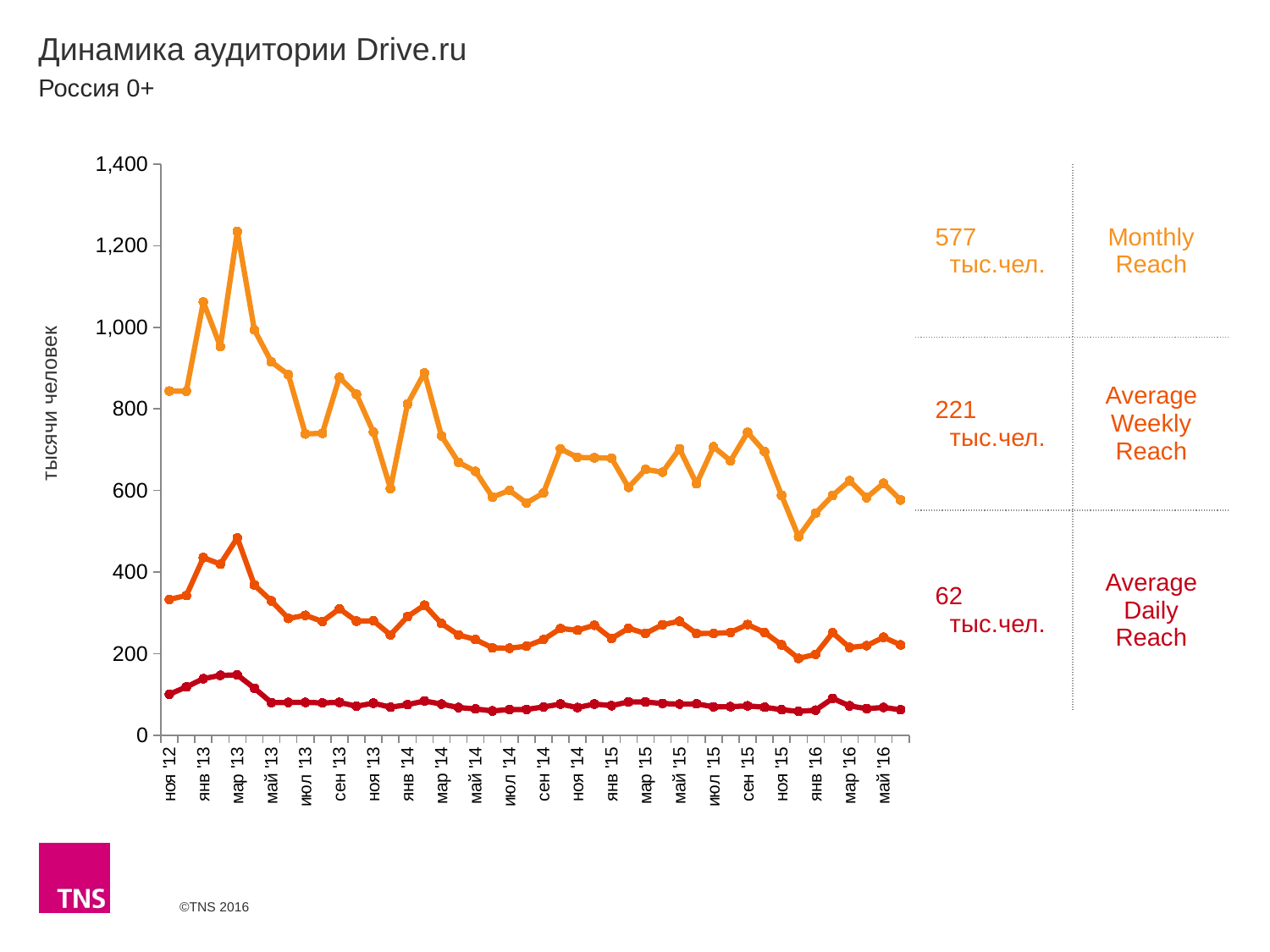
What is the difference between the latest Monthly Reach and Average Weekly Reach values shown on the slide? 356 тыс.чел. What kind of chart is shown on the slide? line chart Is the Average Daily Reach value for мар '13 greater or less than 200? less How many series are plotted on the chart? 3 What is the latest Monthly Reach value shown on the slide? 577 тыс.чел. Is the Monthly Reach value for мар '13 greater or less than 1,000? greater Which is larger for Monthly Reach: the value in мар '13 or the value in май '16? мар '13 Which series has the lowest values throughout the chart? Average Daily Reach What is the label on the vertical axis of the chart? тысячи человек Which series has the highest values throughout the chart? Monthly Reach What is the latest Average Daily Reach value shown on the slide? 62 тыс.чел. What is the latest Average Weekly Reach value shown on the slide? 221 тыс.чел.